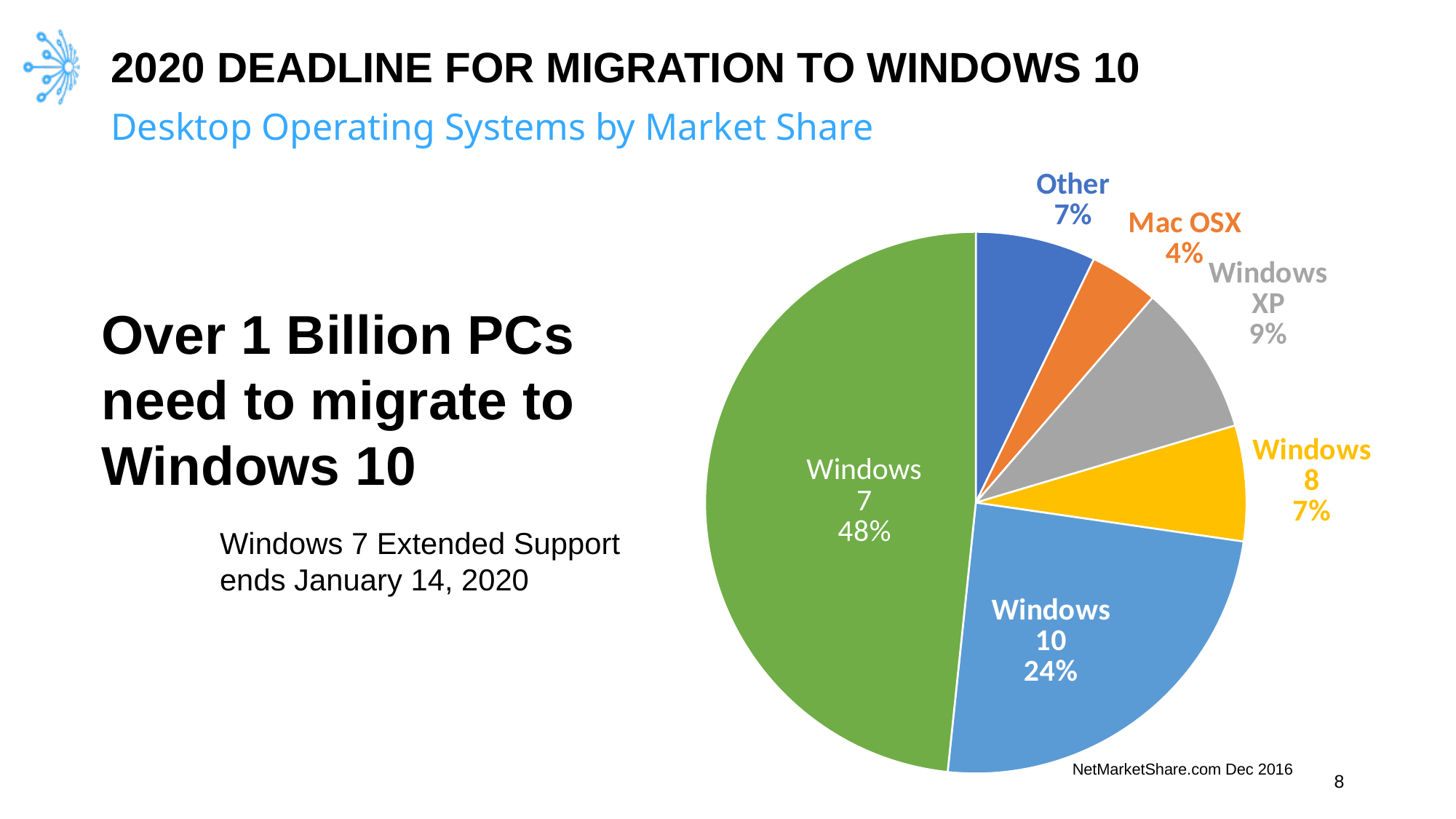
What is the title of the chart on the slide? Desktop Operating Systems by Market Share What is the combined market share of Windows 8 and Other? 14% Which operating system has the smallest slice of the pie chart? Mac OSX What is the market share of Windows 7 in the pie chart? 48% How many slices does the pie chart have? 6 What is the market share of Mac OSX in the pie chart? 4% What kind of chart is shown on the slide? Pie chart What is the market share of Windows 10 in the pie chart? 24% Which operating system has the largest slice of the pie chart? Windows 7 What is the difference in market share between Windows 7 and Windows 10? 24% What is the market share of Windows XP in the pie chart? 9% Which has a larger market share, Windows XP or Windows 8? Windows XP